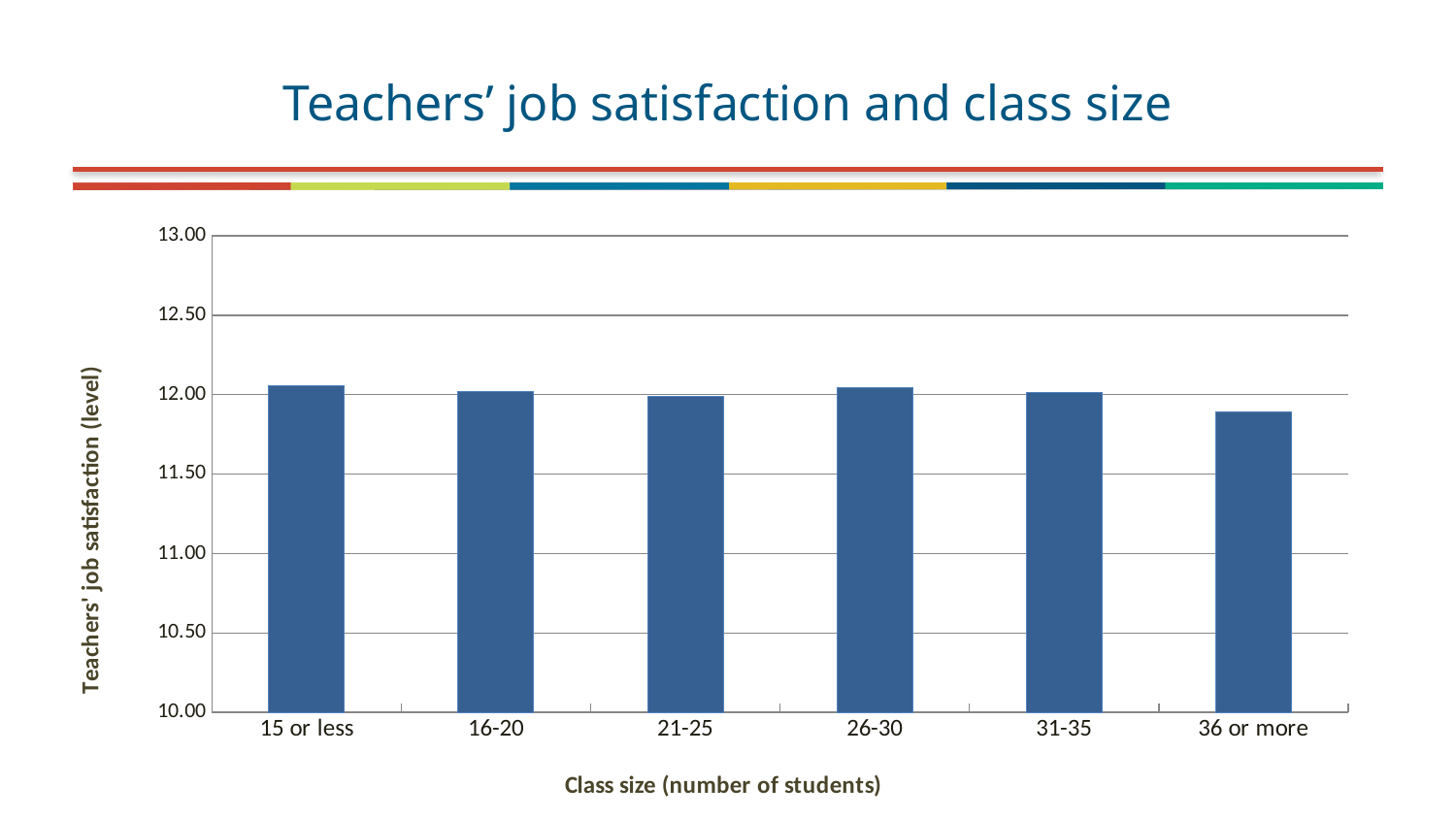
Which class-size category has the lowest teachers' job satisfaction? 36 or more What is the label of the x axis? Class size (number of students) Is the value for the '26-30' class size greater or less than 11.50? greater What kind of chart is shown on the slide? bar chart Which has the higher teachers' job satisfaction: '26-30' or '36 or more'? 26-30 Is the value for the '31-35' class size greater or less than 12.50? less How many class-size categories are shown on the x axis? 6 What is the title of the chart? Teachers' job satisfaction and class size Is the value for the '36 or more' class size greater or less than 12.00? less Which has the higher teachers' job satisfaction: '15 or less' or '36 or more'? 15 or less